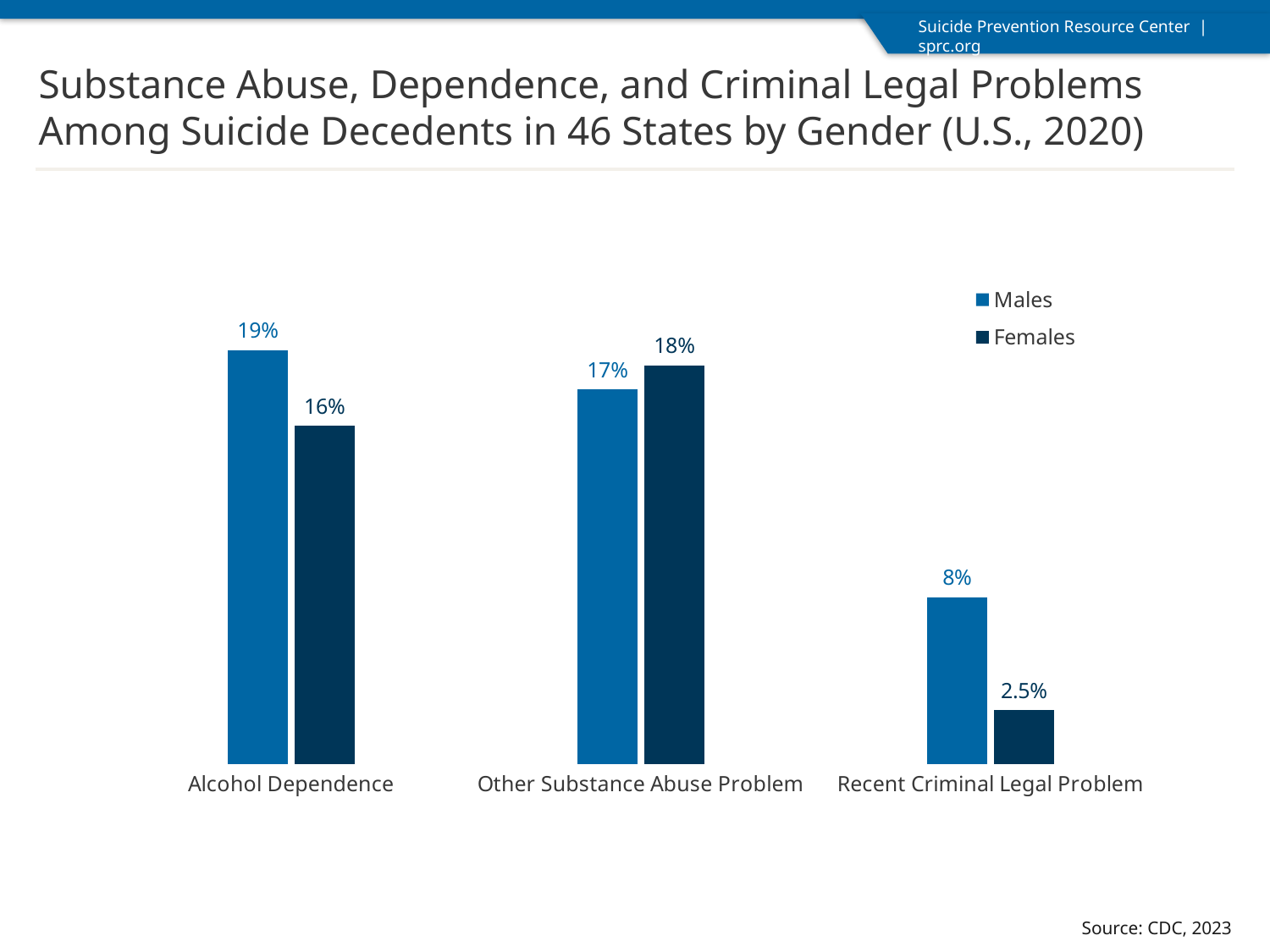
How many series does the legend list? 2 What is the value for Males for Alcohol Dependence? 19% What is the value for Females for Other Substance Abuse Problem? 18% What is the source cited for the chart? CDC, 2023 How many categories are shown on the x axis? 3 What is the difference between the Males and Females values for Recent Criminal Legal Problem? 5.5% What is the value for Females for Recent Criminal Legal Problem? 2.5% For Other Substance Abuse Problem, which is larger: the Males value or the Females value? Females What is the difference between the Males and Females values for Alcohol Dependence? 3% Which category has the lowest value for Females? Recent Criminal Legal Problem Which category has the highest value for Males? Alcohol Dependence What kind of chart is shown on the slide? Bar chart